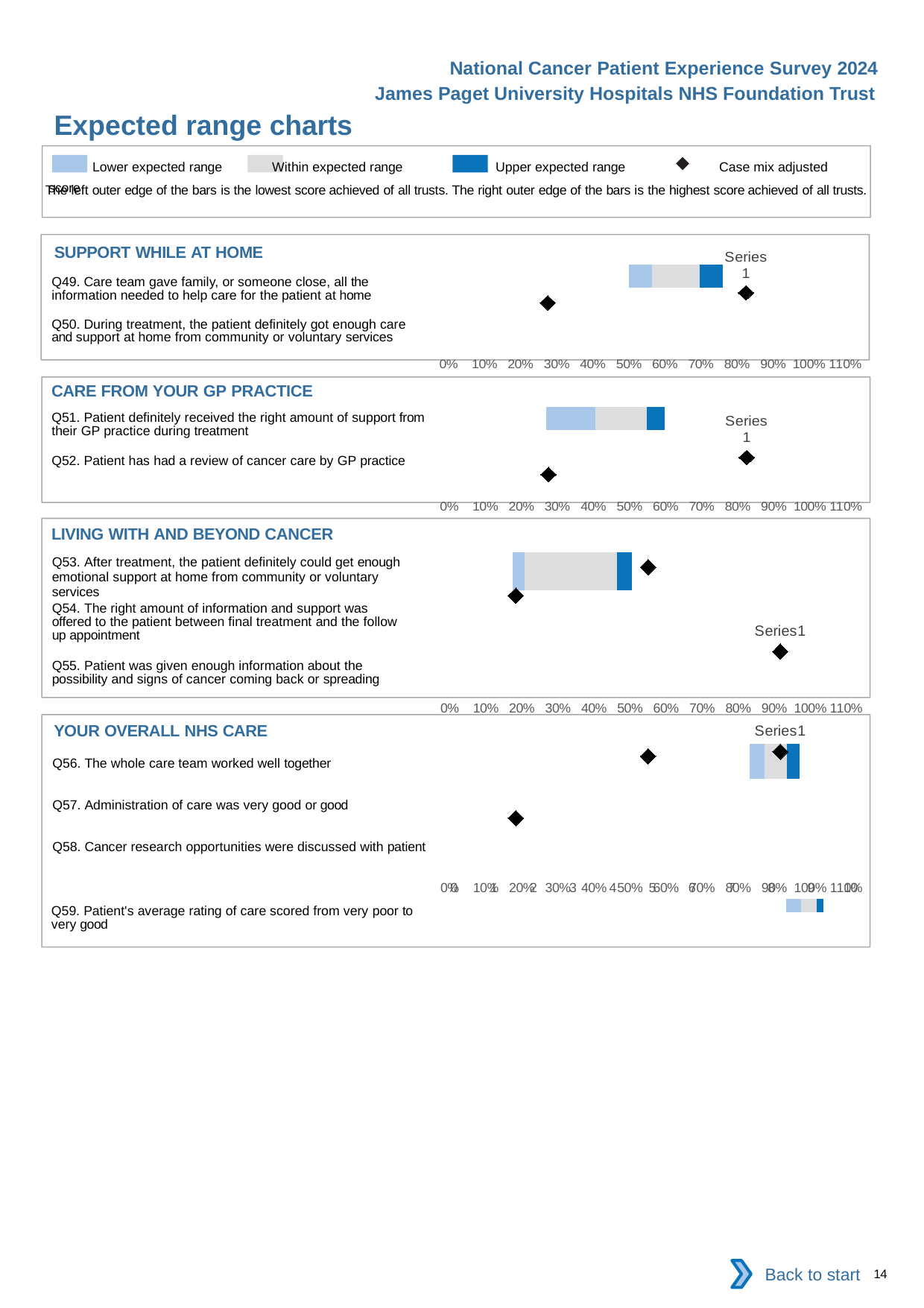
How many entries does the legend at the top of the slide list? 4 What kind of chart is used in the SUPPORT WHILE AT HOME section? bar chart According to the legend, what does the black diamond marker represent? Case mix adjusted score In the LIVING WITH AND BEYOND CANCER chart, is the left edge of the expected range bar greater or less than 30%? less In the CARE FROM YOUR GP PRACTICE chart, is the right edge of the expected range bar greater or less than 70%? less What is the highest tick label shown on the x axis of the SUPPORT WHILE AT HOME chart? 110% How many questions are listed in the YOUR OVERALL NHS CARE section? 4 According to the legend, what does the dark blue colour represent? Upper expected range In the SUPPORT WHILE AT HOME chart, is the left edge of the expected range bar greater or less than 40%? greater How many questions are listed in the CARE FROM YOUR GP PRACTICE section? 2 How many questions are listed in the LIVING WITH AND BEYOND CANCER section? 3